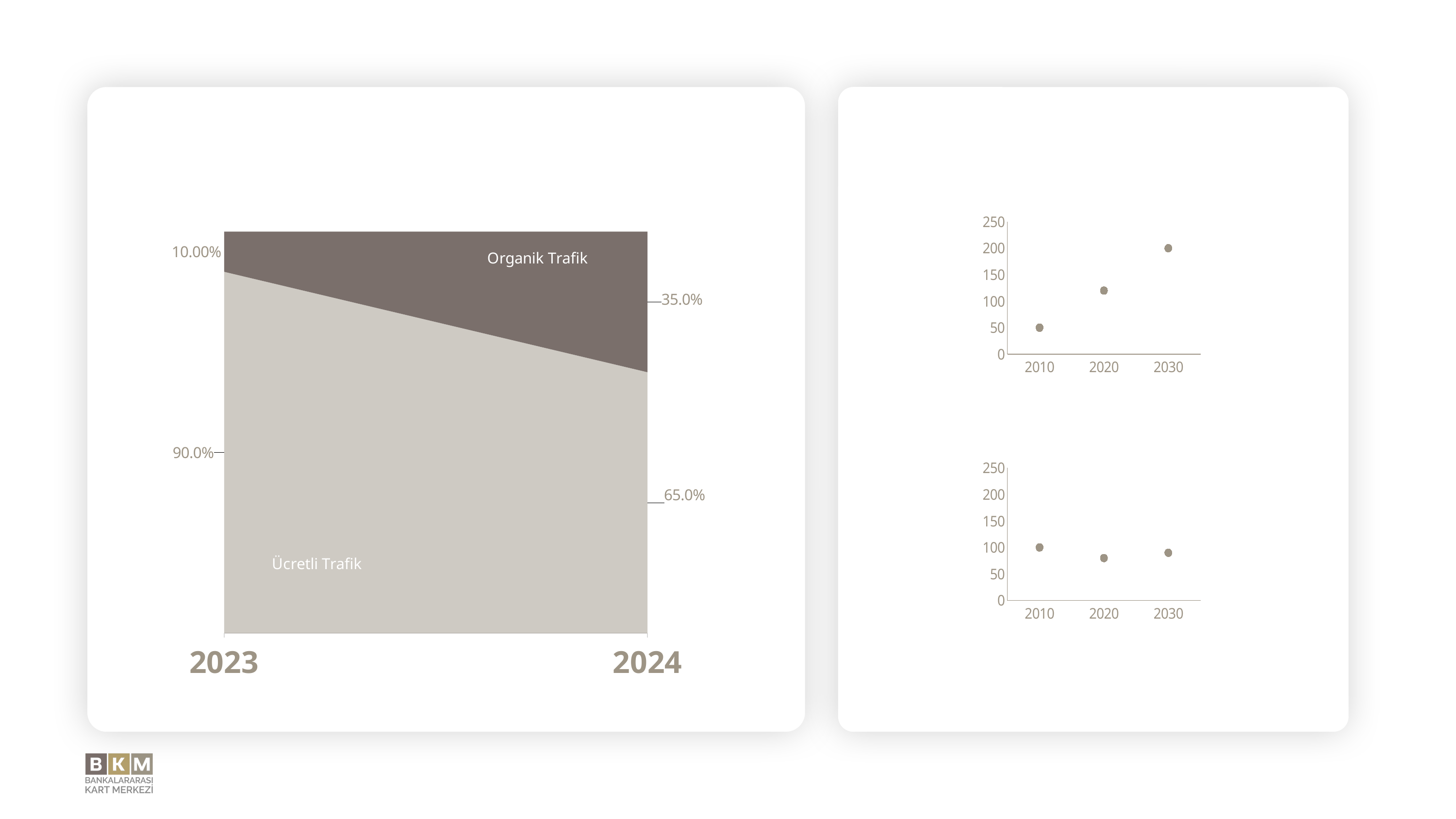
On the left chart, which series has the larger value in 2024, Organik Trafik or Ücretli Trafik? Ücretli Trafik On the left chart, what is the difference between the Ücretli Trafik values in 2023 and 2024? 25.0% On the top right chart, do the values rise or fall from 2010 to 2030? rise On the left chart, what is the value for Organik Trafik in 2024? 35.0% On the left chart, how many series are shown? 2 On the bottom right chart, how many data points are plotted? 3 On the bottom right chart, which year has the highest value? 2010 On the left chart, does the share of Organik Trafik rise or fall from 2023 to 2024? rise On the top right chart, what is the value for 2030? 200 On the top right chart, is the value for 2020 greater or less than 100? greater On the left chart, what is the value for Ücretli Trafik in 2024? 65.0% On the left chart, what is the value for Organik Trafik in 2023? 10.00%